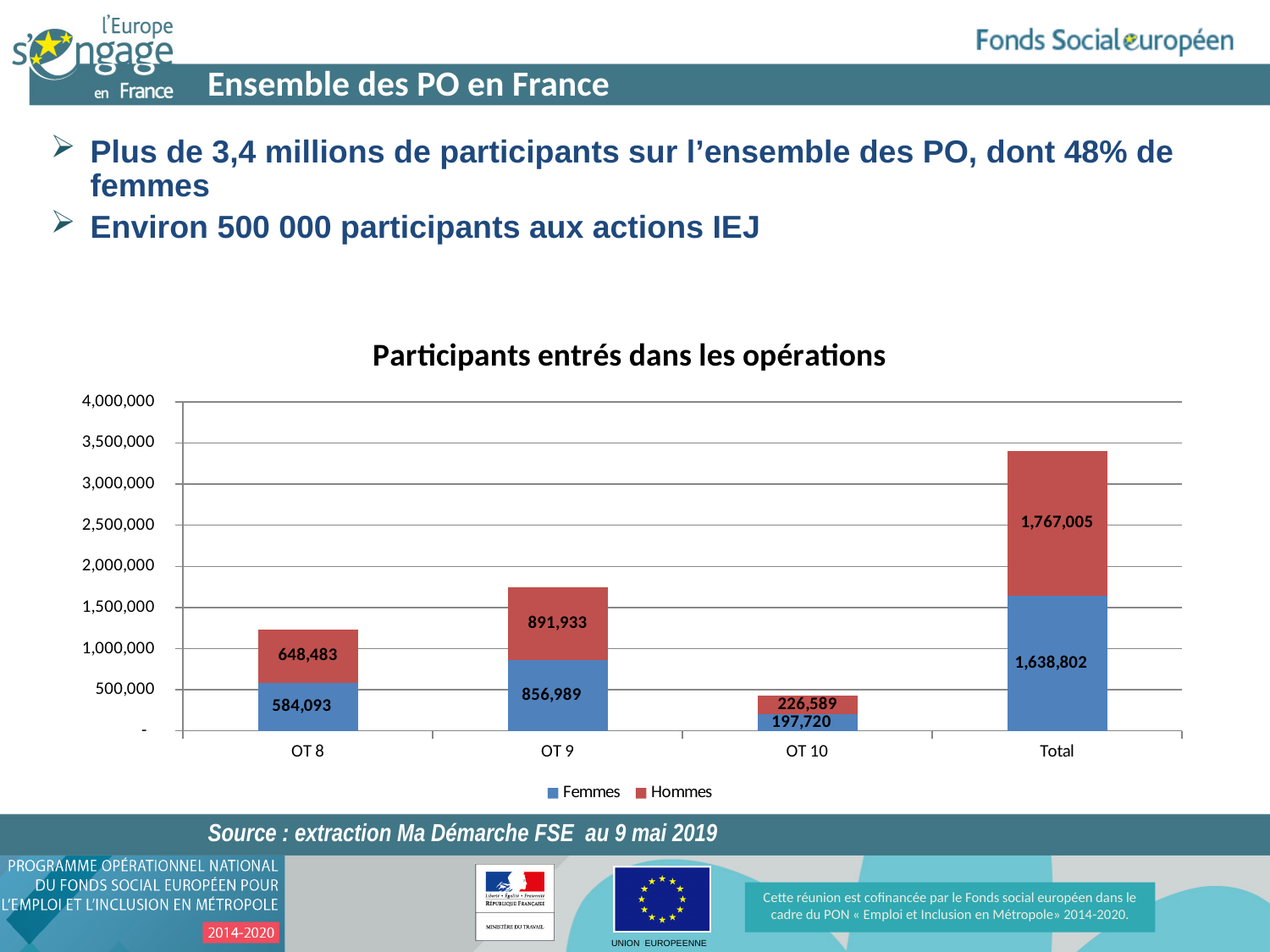
What is the value for Femmes in the OT 9 category? 856,989 How many series does the legend list? 2 Among OT 8, OT 9 and OT 10, which category has the lowest Femmes value? OT 10 What is the value for Femmes in the OT 10 category? 197,720 How many categories are shown on the x axis? 4 What is the value for Hommes in the Total category? 1,767,005 Among OT 8, OT 9 and OT 10, which category has the highest Hommes value? OT 9 What is the total of the stacked bar for OT 9? 1,748,922 What type of chart is shown on the slide? Stacked bar chart What is the value for Hommes in the OT 8 category? 648,483 What is the difference between the Hommes and Femmes values in the OT 8 category? 64,390 Which is larger in the OT 10 category, the Femmes value or the Hommes value? Hommes